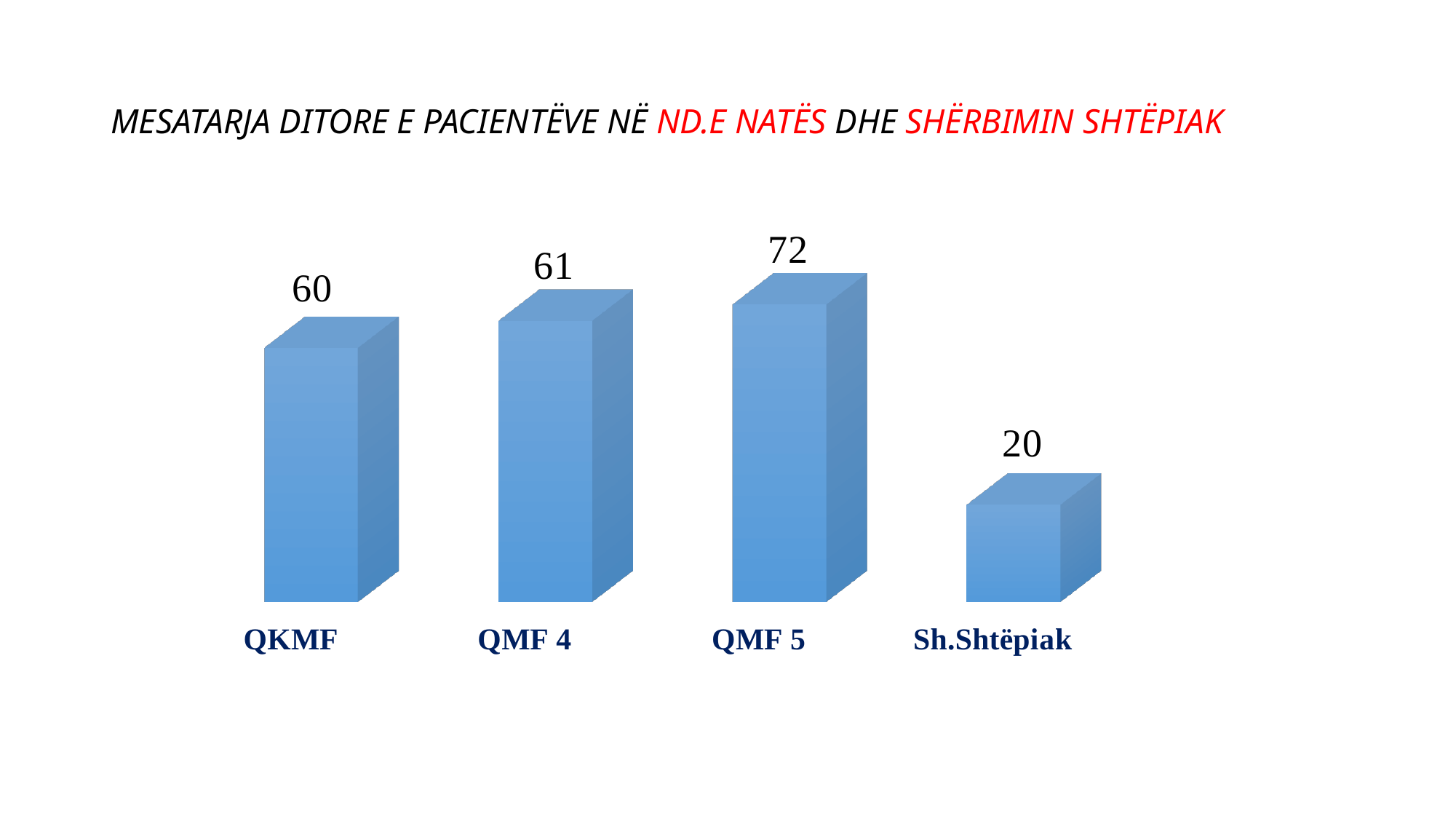
What is the value for QKMF? 60 How many categories are shown in the chart? 4 What is the value for QMF 5? 72 Which category has the highest value? QMF 5 Which is larger, the value for QMF 5 or the value for Sh.Shtëpiak? QMF 5 What is the title of the slide? MESATARJA DITORE E PACIENTËVE NË ND.E NATËS DHE SHËRBIMIN SHTËPIAK What is the difference between the values for QMF 4 and Sh.Shtëpiak? 41 What is the value for Sh.Shtëpiak? 20 What is the difference between the values for QMF 5 and QKMF? 12 Which category has the lowest value? Sh.Shtëpiak What is the value for QMF 4? 61 What kind of chart is shown on the slide? bar chart